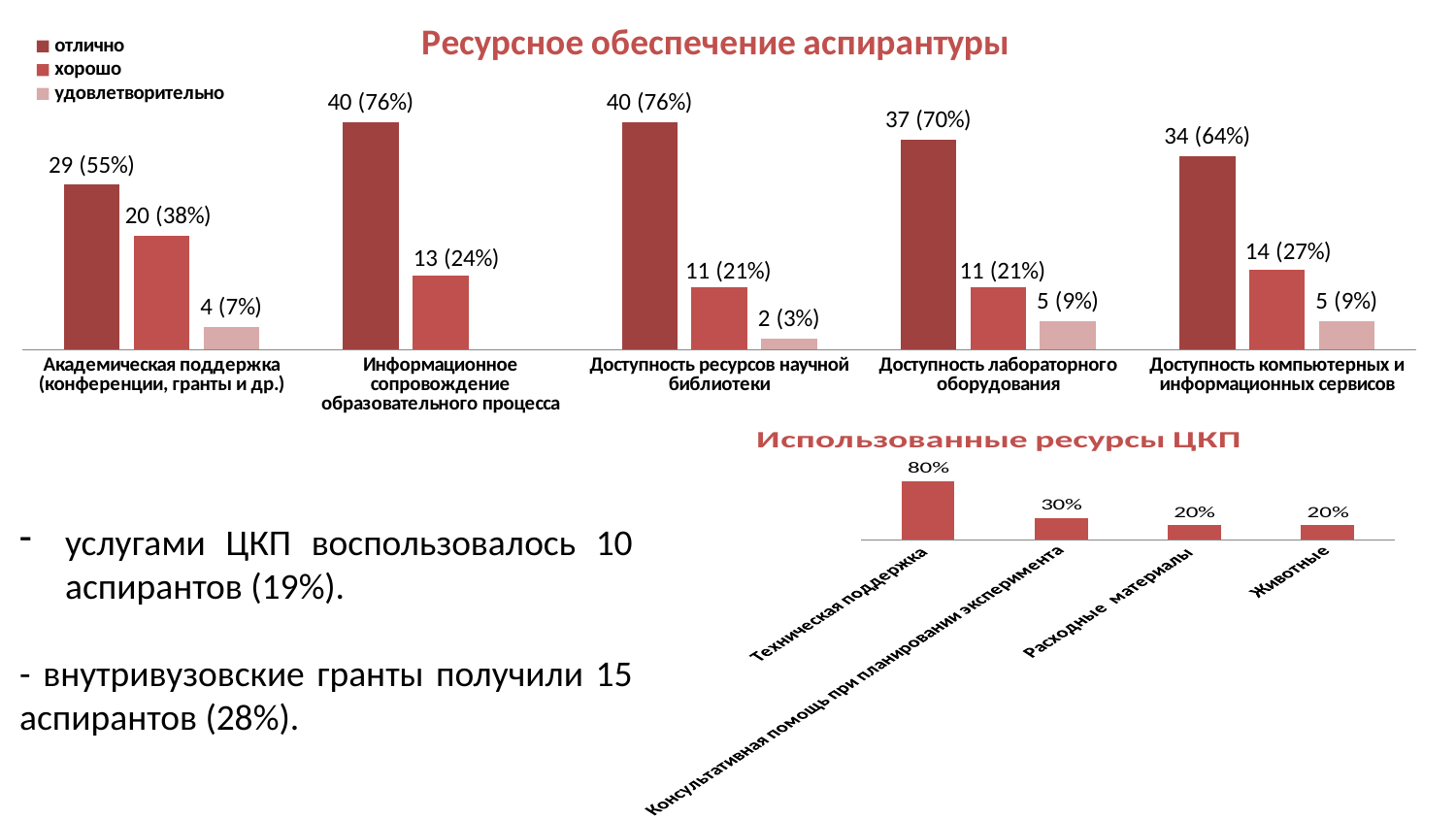
In the chart 'Ресурсное обеспечение аспирантуры', how many categories are shown on the x axis? 5 In the chart 'Использованные ресурсы ЦКП', how many categories are shown? 4 In the chart 'Ресурсное обеспечение аспирантуры', how many series does the legend list? 3 In the chart 'Ресурсное обеспечение аспирантуры', what is the difference between the 'отлично' and 'хорошо' counts for 'Информационное сопровождение образовательного процесса'? 27 In the chart 'Ресурсное обеспечение аспирантуры', what is the value for 'отлично' in the category 'Доступность лабораторного оборудования'? 37 (70%) In the chart 'Использованные ресурсы ЦКП', what is the value for 'Техническая поддержка'? 80% What type of chart is 'Использованные ресурсы ЦКП'? Bar chart In the chart 'Ресурсное обеспечение аспирантуры', what is the value for 'удовлетворительно' in the category 'Доступность ресурсов научной библиотеки'? 2 (3%) In the chart 'Ресурсное обеспечение аспирантуры', what is the value for 'хорошо' in the category 'Академическая поддержка (конференции, гранты и др.)'? 20 (38%) In the chart 'Использованные ресурсы ЦКП', which category has the highest value? Техническая поддержка In the chart 'Ресурсное обеспечение аспирантуры', which category has the lowest 'отлично' value? Академическая поддержка (конференции, гранты и др.) In the chart 'Ресурсное обеспечение аспирантуры', which is larger: the 'хорошо' value for 'Доступность компьютерных и информационных сервисов' or for 'Доступность лабораторного оборудования'? Доступность компьютерных и информационных сервисов